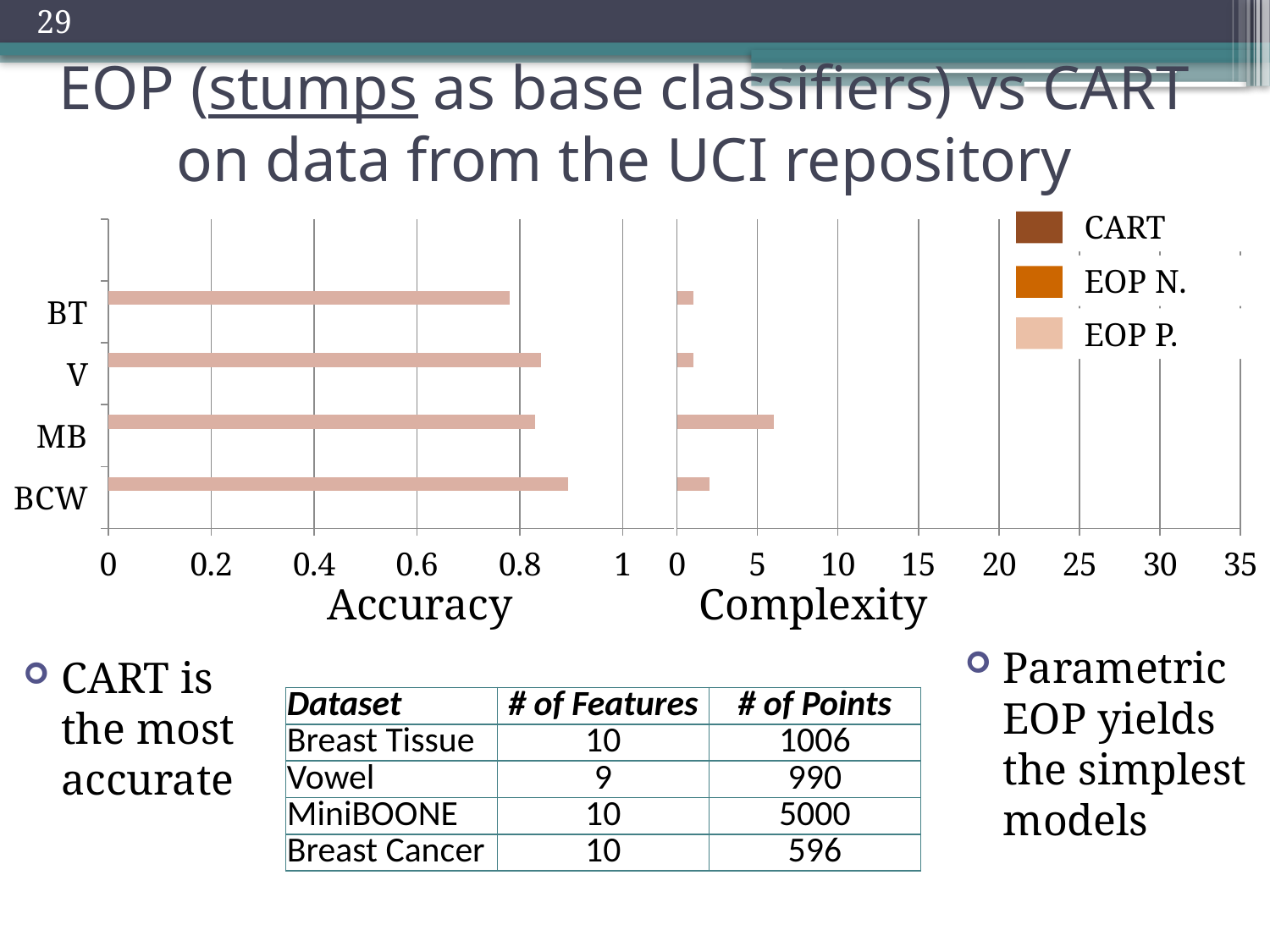
How many categories are shown on the Accuracy chart? 4 On the Complexity chart, is the value for MB greater or less than 5? greater On the Complexity chart, which category has the highest complexity? MB On the Accuracy chart, is the value for BT greater or less than 0.8? less On the Accuracy chart, which is larger, the value for BCW or the value for BT? BCW How many series does the legend list? 3 What kind of chart is the Accuracy chart on the left? bar chart On the Accuracy chart, which category has the highest accuracy? BCW On the Complexity chart, is the value for BCW greater or less than 5? less What is the x-axis label of the chart on the right? Complexity On the Accuracy chart, which category has the lowest accuracy? BT